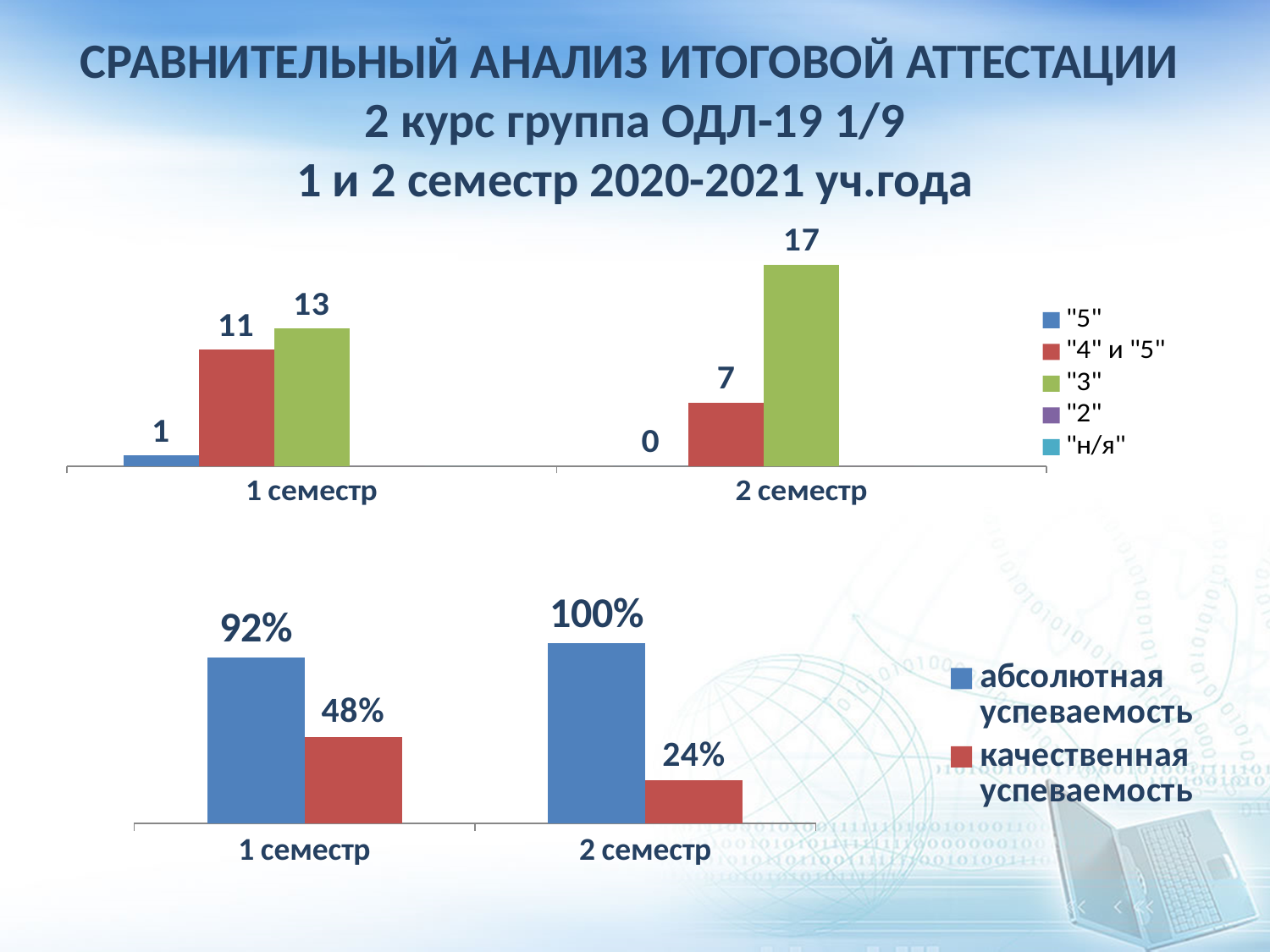
In the bottom chart, what is the value of качественная успеваемость in 1 семестр? 48% What kind of chart is the bottom chart? bar chart In the bottom chart, what is the difference between качественная успеваемость in 1 семестр and 2 семестр? 24% In the top chart, what is the value for "4" и "5" in 1 семестр? 11 How many series does the legend of the top chart list? 5 In the top chart, what is the value for "5" in 2 семестр? 0 In the top chart, what is the difference between the "3" values for 2 семестр and 1 семестр? 4 In the top chart, which is larger: "4" и "5" in 1 семестр or "4" и "5" in 2 семестр? 1 семестр In the bottom chart, what is the value of абсолютная успеваемость in 2 семестр? 100% In the top chart, which series has the highest value in 1 семестр? "3" In the top chart, what is the value for "3" in 2 семестр? 17 In the bottom chart, does качественная успеваемость rise or fall from 1 семестр to 2 семестр? fall